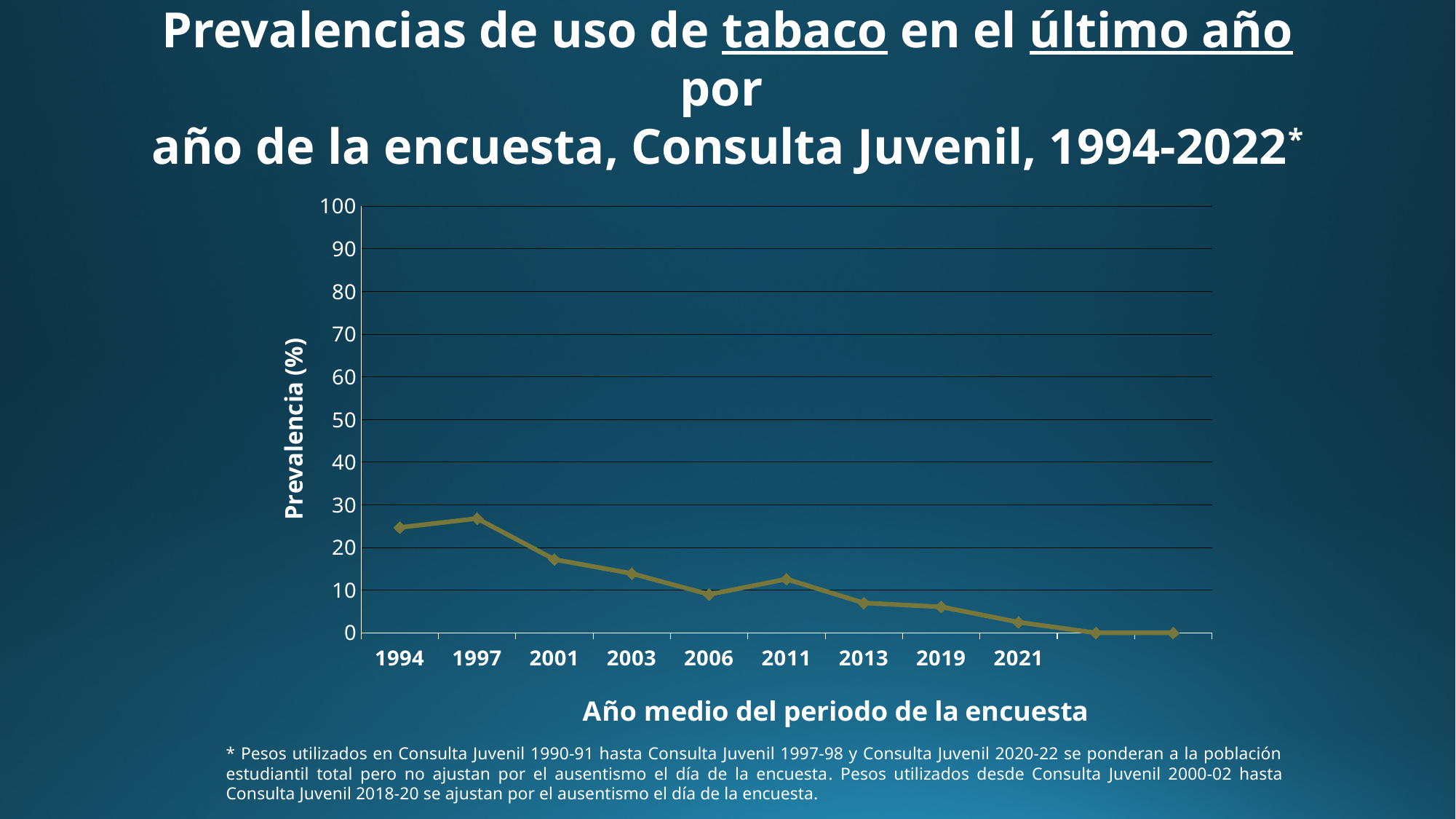
Is the prevalence value for 1994 greater or less than 20? greater What is the label of the vertical axis? Prevalencia (%) What kind of chart is shown on the slide? line chart Is the prevalence value for 2021 greater or less than 10? less Is the prevalence value for 2011 greater or less than 10? greater Which has the higher prevalence value, 2001 or 2003? 2001 Which year has the highest prevalence value on the chart? 1997 Which has the higher prevalence value, 2006 or 2011? 2011 Overall, do the prevalence values rise or fall from 1994 to 2021? fall